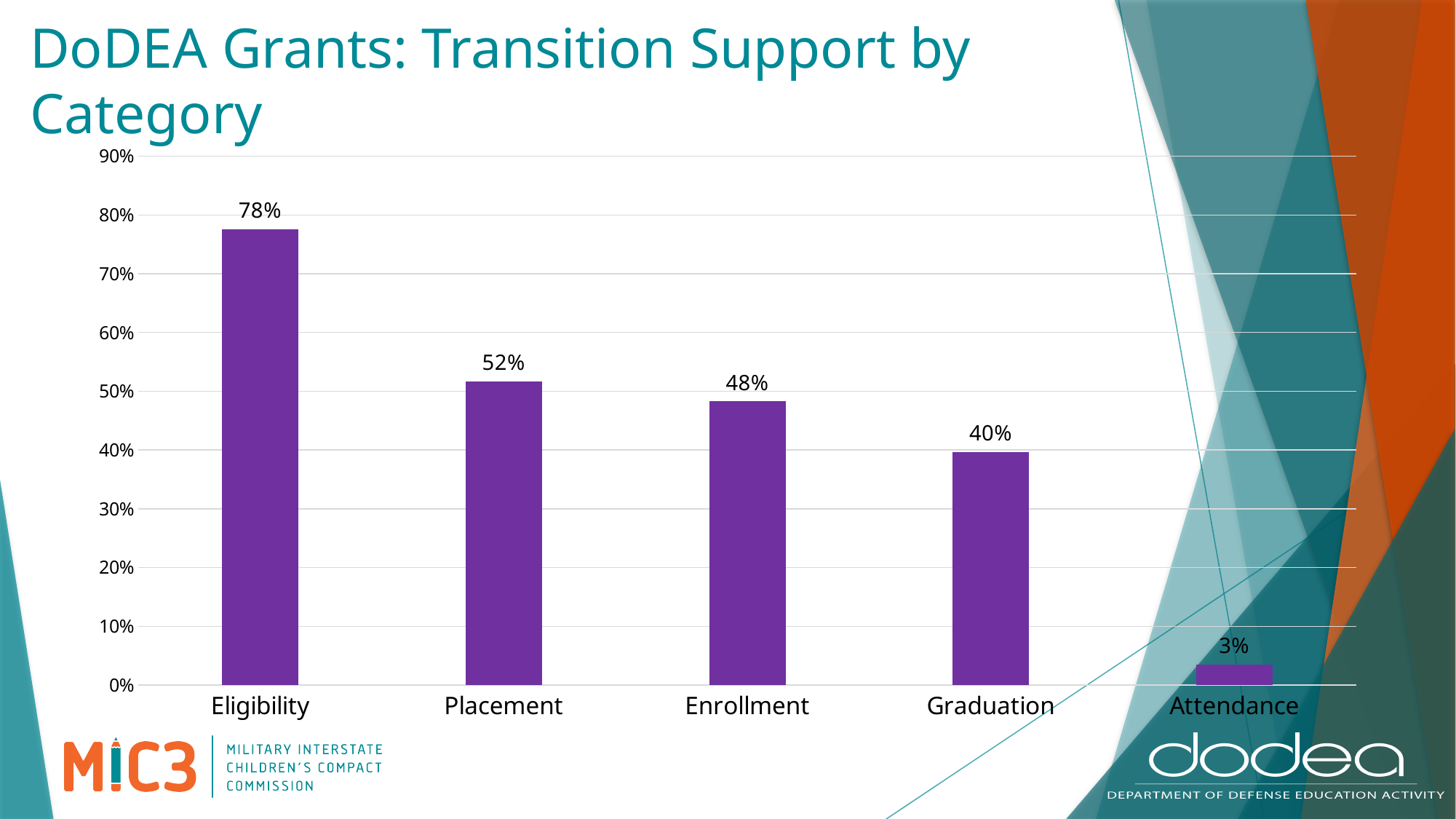
Is the value for Graduation greater or less than 50%? less Which category has the lowest value? Attendance Which category has the highest value? Eligibility What is the value for Eligibility? 78% What is the value for Attendance? 3% What is the value for Enrollment? 48% What kind of chart is shown on the slide? bar chart Which is larger, the value for Placement or the value for Enrollment? Placement What is the difference between the values for Eligibility and Graduation? 38% How many categories are shown on the x axis? 5 What is the value for Placement? 52% What is the title of the slide? DoDEA Grants: Transition Support by Category